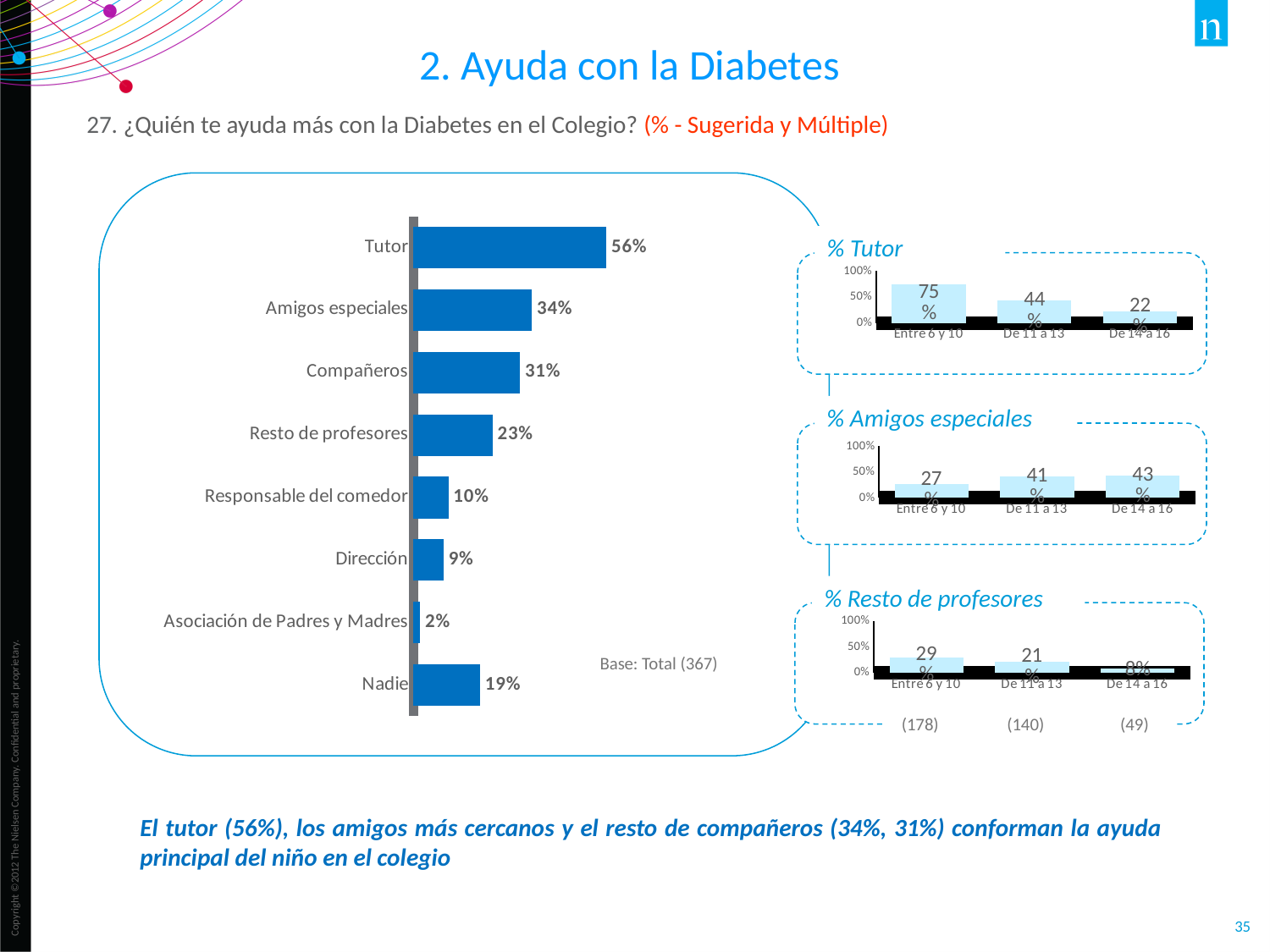
In the main bar chart on the left, which is larger: Nadie or Dirección? Nadie In the main bar chart on the left, what is the value for Responsable del comedor? 10% How many categories does the main bar chart on the left show? 8 In the main bar chart on the left, what is the difference between Amigos especiales and Compañeros? 3% In the main bar chart on the left, what is the value for Tutor? 56% In the main bar chart on the left, which category has the lowest value? Asociación de Padres y Madres In the '% Resto de profesores' chart, what is the value for De 14 a 16? 8% In the '% Amigos especiales' chart, which age group has the highest value? De 14 a 16 In the '% Resto de profesores' chart, what is the difference between Entre 6 y 10 and De 11 a 13? 8% What kind of chart is the main chart on the left? Bar chart In the '% Tutor' chart, do the values rise or fall from Entre 6 y 10 to De 14 a 16? Fall In the '% Tutor' chart, what is the value for Entre 6 y 10? 75%